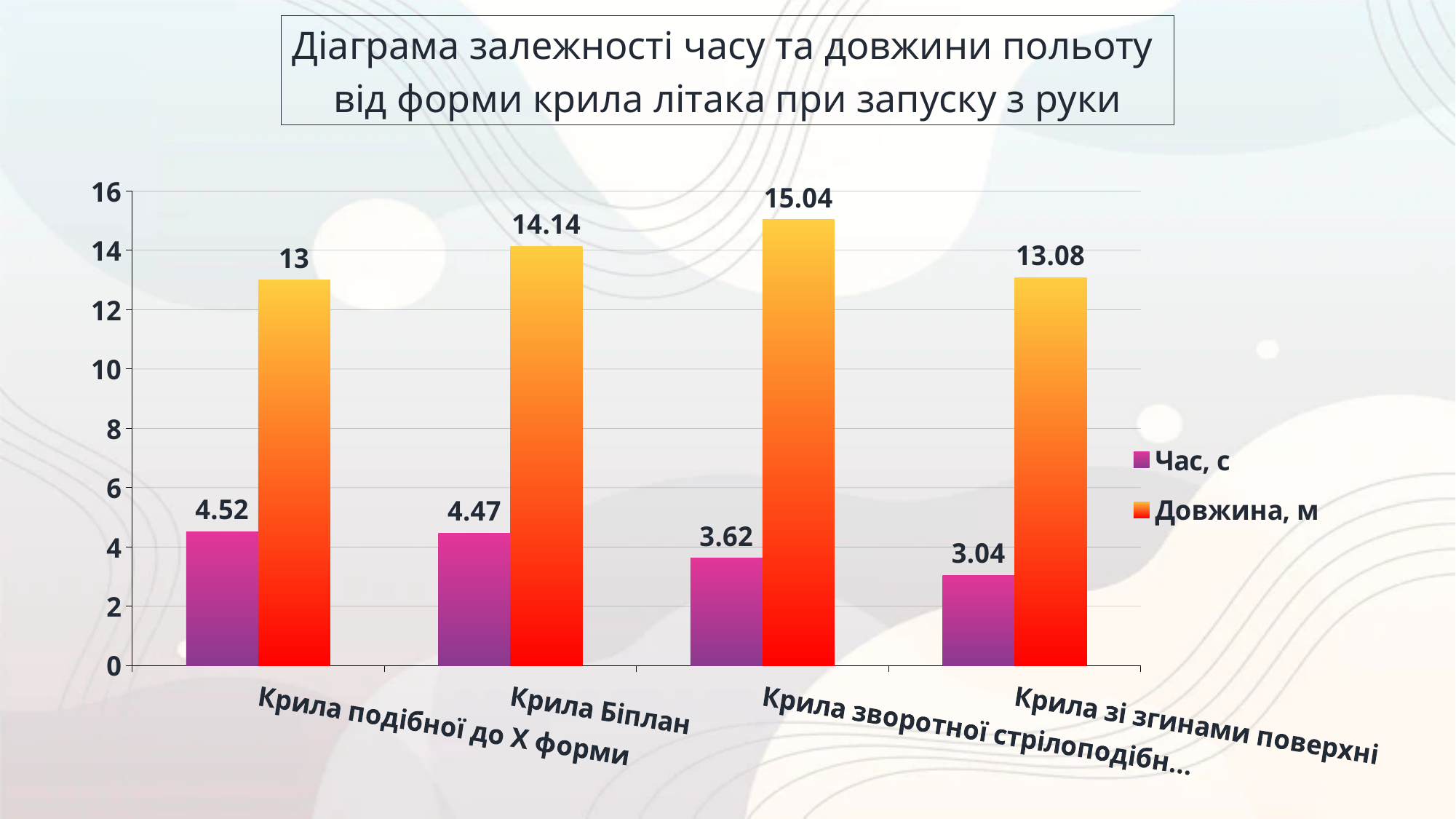
What is the title of the chart? Діаграма залежності часу та довжини польоту від форми крила літака при запуску з руки What is the value of "Час, с" for "Крила Біплан"? 4.47 How many series does the legend list? 2 What is the difference between the "Довжина, м" values for "Крила Біплан" and "Крила подібної до Х форми"? 1.14 Which category has the lowest "Час, с" value? Крила зі згинами поверхні What is the value of "Час, с" for "Крила подібної до Х форми"? 4.52 Which is larger: the "Час, с" value for "Крила Біплан" or for "Крила зворотної стрілоподібн..."? Крила Біплан Which category has the highest "Довжина, м" value? Крила зворотної стрілоподібн... What type of chart is shown on the slide? bar chart How many wing-shape categories are shown on the x axis? 4 What is the value of "Довжина, м" for "Крила зі згинами поверхні"? 13.08 Do the "Час, с" values rise or fall from left to right along the x axis? fall